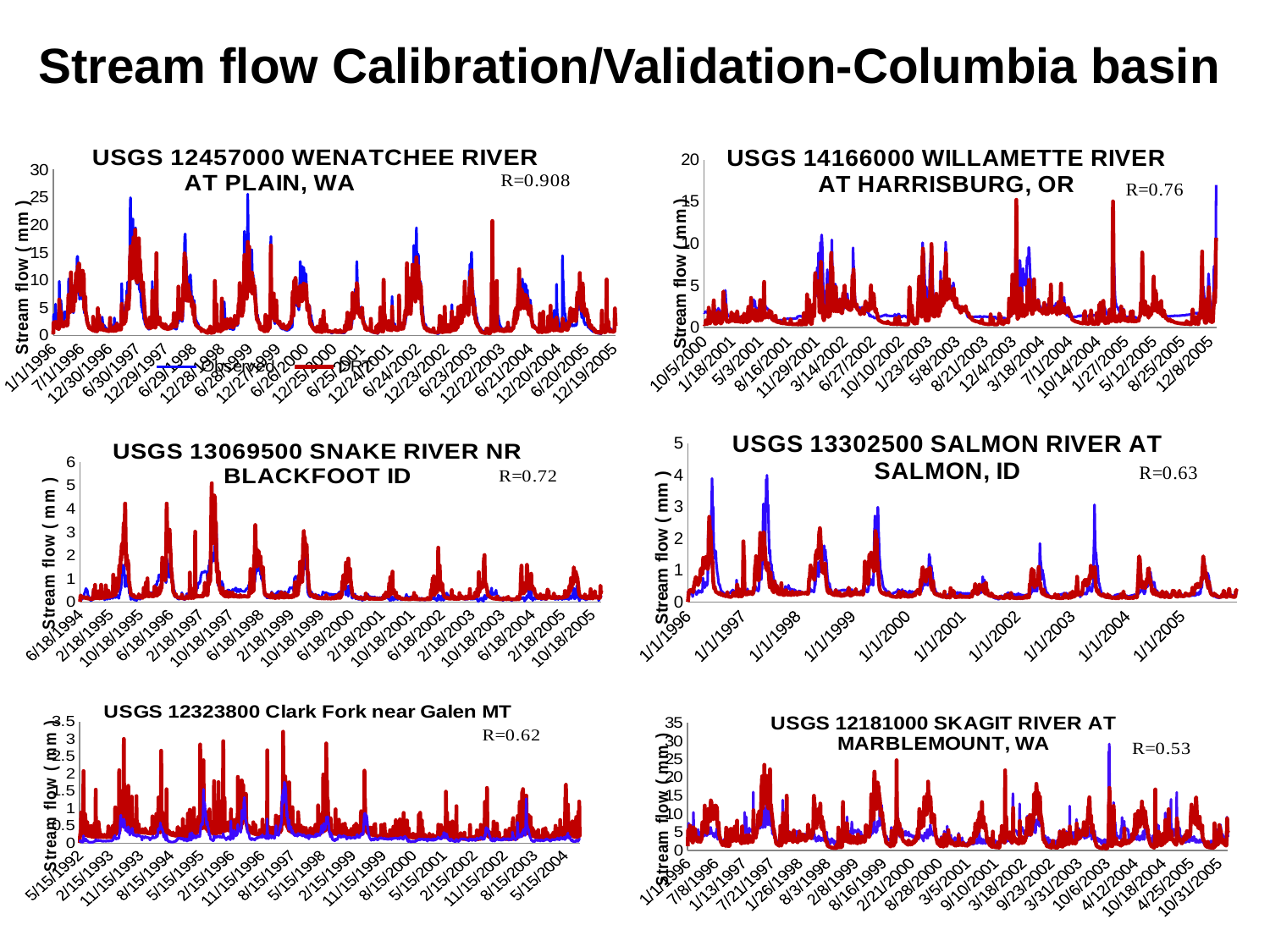
Which has a higher printed R value, the USGS 13069500 SNAKE RIVER NR BLACKFOOT ID chart or the USGS 13302500 SALMON RIVER AT SALMON, ID chart? USGS 13069500 SNAKE RIVER NR BLACKFOOT ID What is the difference between the R value on the Wenatchee River chart and the R value on the Skagit River chart? 0.378 Which chart on the slide has the highest printed R value? USGS 12457000 WENATCHEE RIVER AT PLAIN, WA How many line series are plotted on the USGS 12323800 Clark Fork near Galen MT chart? 2 How many charts are shown on the slide? 6 What R value is printed on the USGS 14166000 WILLAMETTE RIVER AT HARRISBURG, OR chart? R=0.76 Which chart on the slide has the lowest printed R value? USGS 12181000 SKAGIT RIVER AT MARBLEMOUNT, WA What kind of chart is used for the USGS 12457000 WENATCHEE RIVER AT PLAIN, WA panel? line chart On the USGS 12457000 WENATCHEE RIVER AT PLAIN, WA chart, is the highest stream flow peak greater or less than 20 mm? greater On the USGS 13302500 SALMON RIVER AT SALMON, ID chart, is the highest stream flow peak greater or less than 3 mm? greater What R value is printed on the USGS 12181000 SKAGIT RIVER AT MARBLEMOUNT, WA chart? R=0.53 What R value is printed on the USGS 12457000 WENATCHEE RIVER AT PLAIN, WA chart? R=0.908